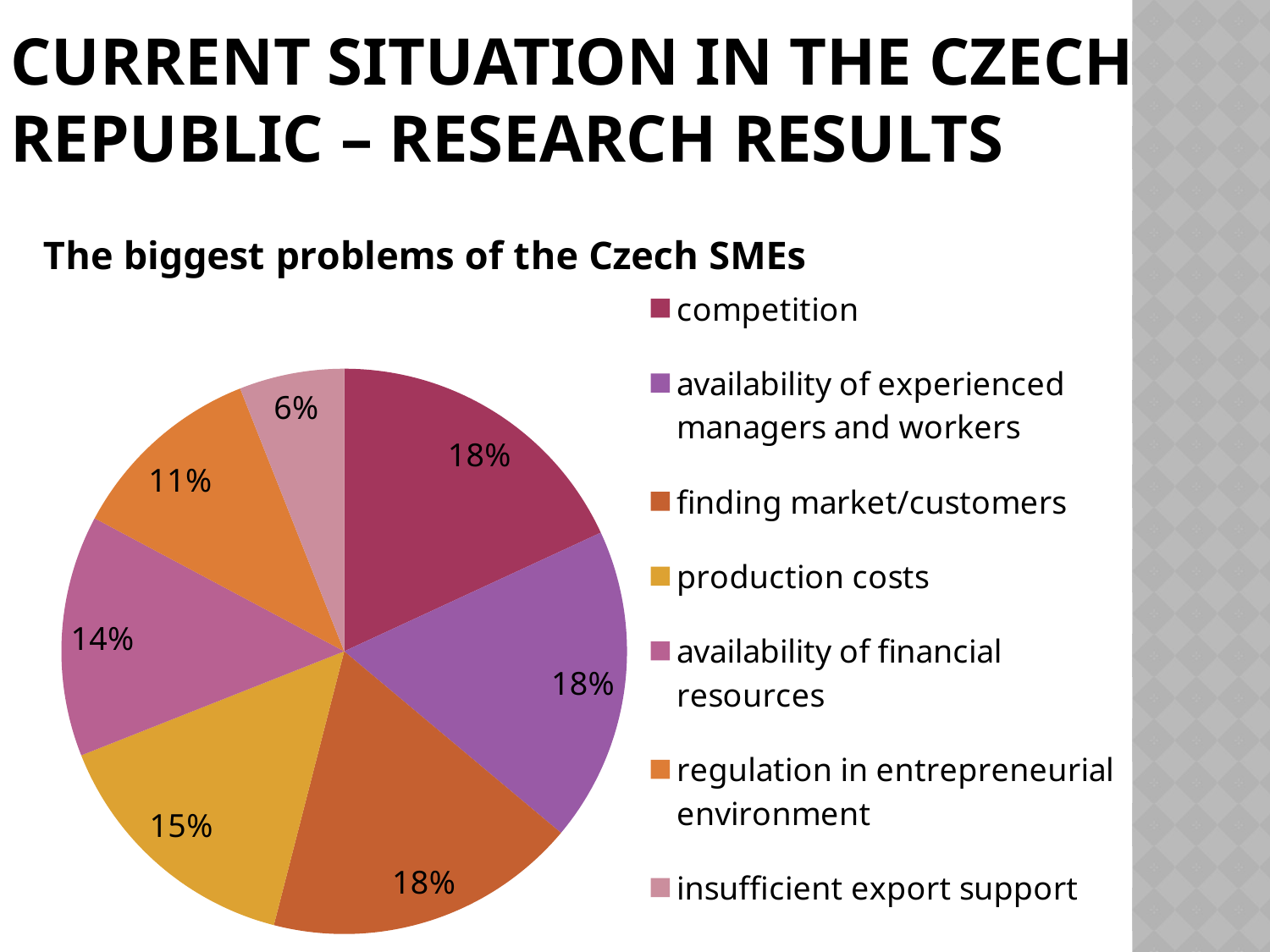
Which category has the smallest slice of the pie? insufficient export support What share of the pie is 'production costs'? 15% What is the difference between the share for 'production costs' and the share for 'availability of financial resources'? 1% What share of the pie is 'competition'? 18% Which is larger: the slice for 'production costs' or the slice for 'regulation in entrepreneurial environment'? production costs What is the title of the chart? The biggest problems of the Czech SMEs How many categories does the pie chart show? 7 What share of the pie is 'availability of financial resources'? 14% What kind of chart is shown on the slide? pie chart What is the difference between the share for 'competition' and the share for 'insufficient export support'? 12%